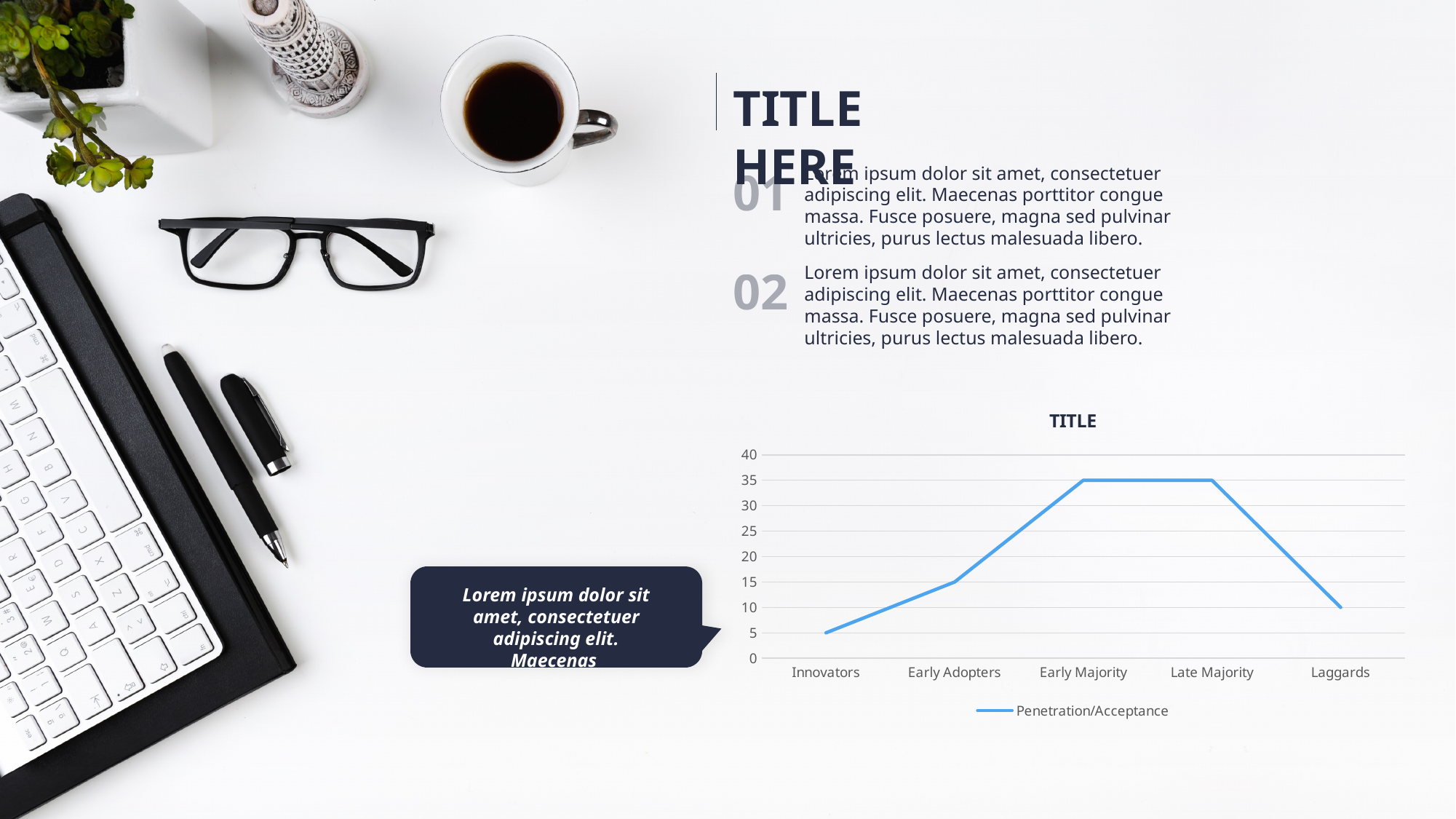
What is the value for Innovators? 5 What is the value for Early Adopters? 15 What is the value for Laggards? 10 Do the values rise or fall from Late Majority to Laggards? fall How many series does the legend list? 1 How many categories are shown on the x axis? 5 What is the name of the series shown in the legend? Penetration/Acceptance Which is larger, the value for Early Adopters or the value for Laggards? Early Adopters What is the value for Late Majority? 35 Which category has the lowest value? Innovators What kind of chart is shown on the slide? line chart Is the value for Early Majority greater or less than 30? greater